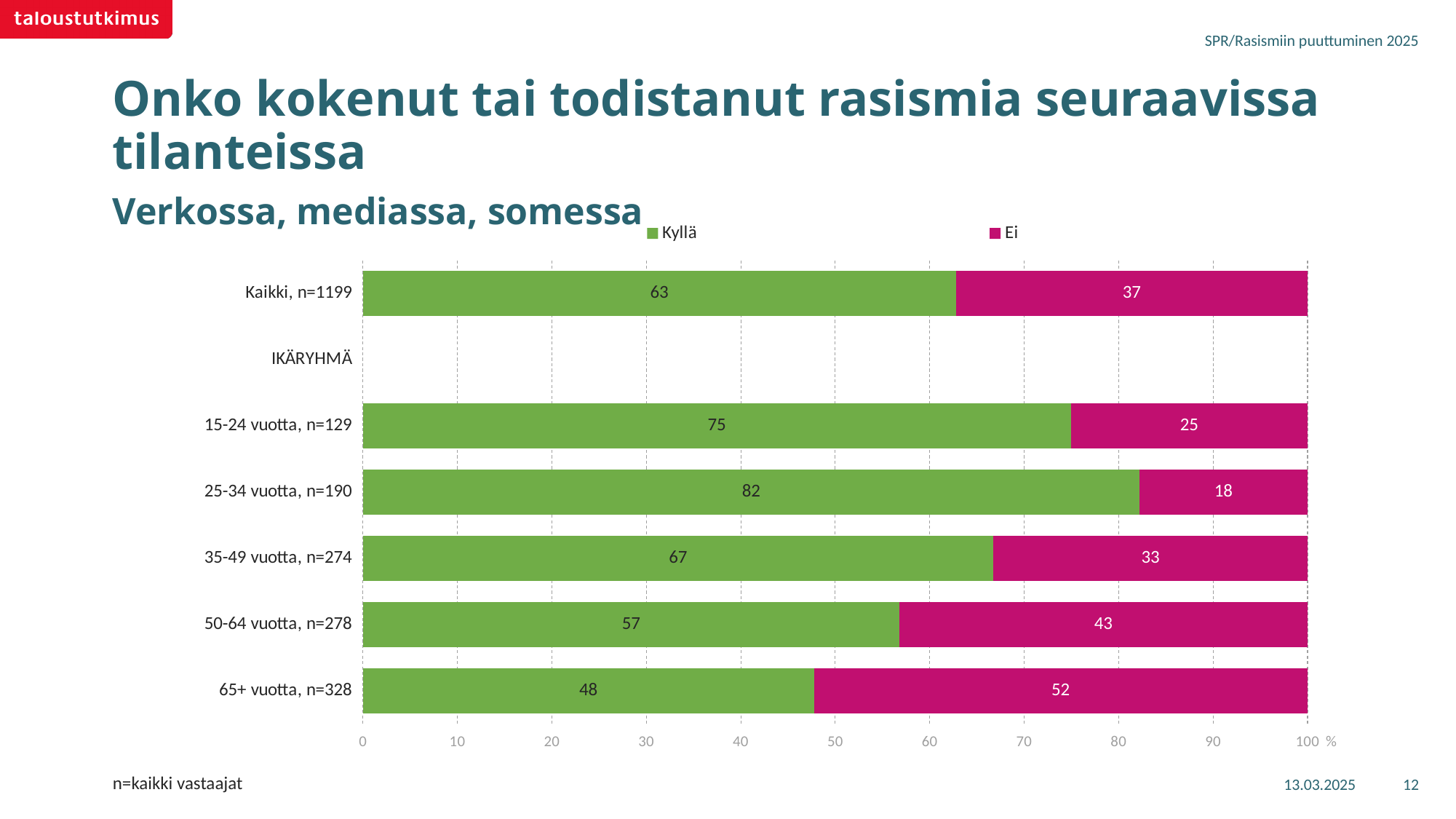
What colour represents the Ei series in the chart? Magenta Which age group has the lowest Kyllä value? 65+ vuotta, n=328 Which age group has the highest Kyllä value? 25-34 vuotta, n=190 What is the Kyllä value for Kaikki, n=1199? 63 What is the Ei value for 65+ vuotta, n=328? 52 What kind of chart is shown on the slide? Stacked bar chart How many series does the legend list? 2 How many bars with data are plotted in the chart? 6 What is the difference between the Kyllä values for 15-24 vuotta, n=129 and 50-64 vuotta, n=278? 18 What is the total of the stacked bar for 50-64 vuotta, n=278? 100 What is the Kyllä value for 35-49 vuotta, n=274? 67 Which is larger: the Ei value for 35-49 vuotta, n=274 or the Ei value for 25-34 vuotta, n=190? 35-49 vuotta, n=274